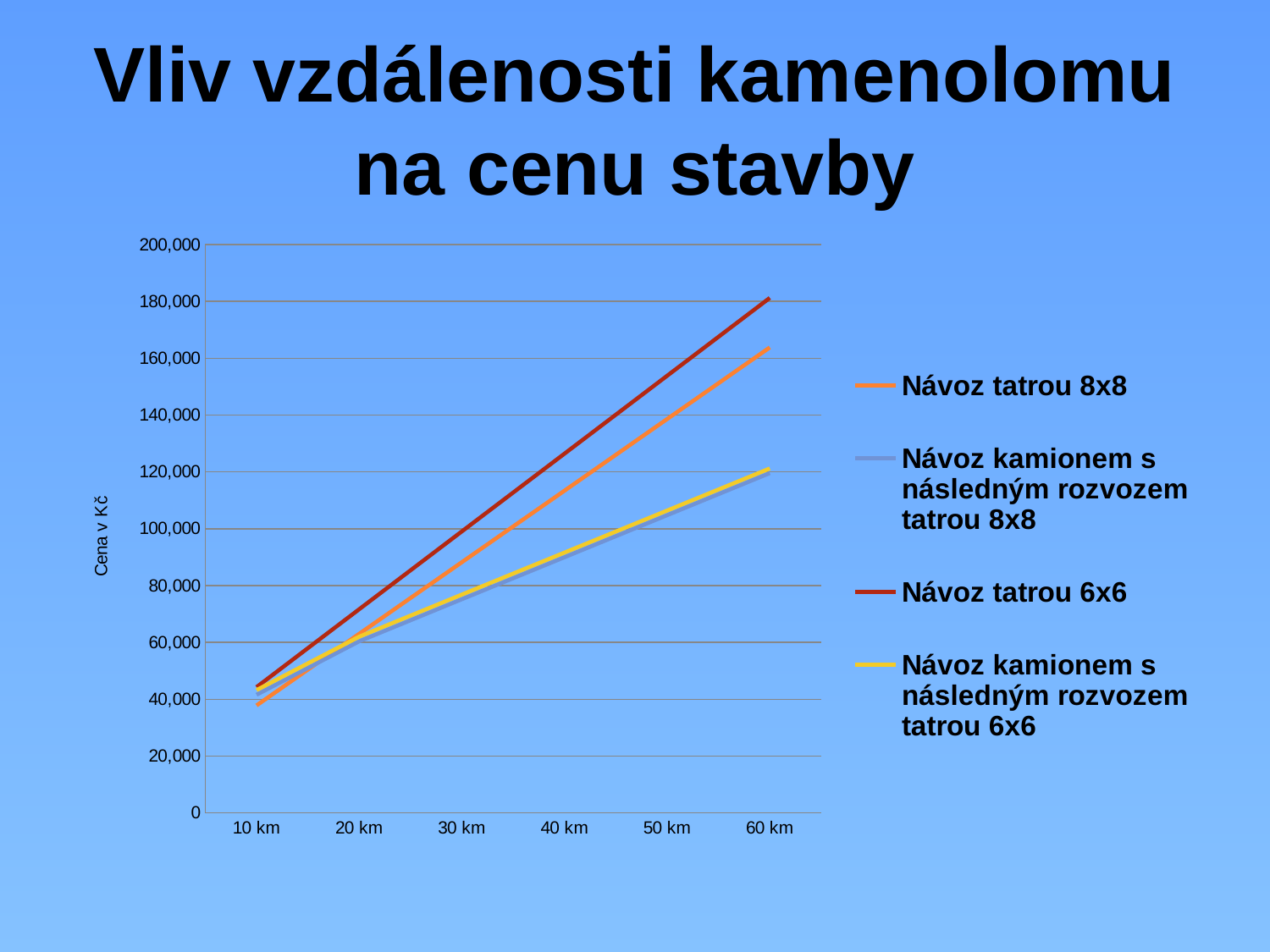
Is the value for Návoz tatrou 6x6 at 60 km greater or less than 160,000? greater Is the value for Návoz tatrou 8x8 at 10 km greater or less than 60,000? less What kind of chart is shown on the slide? line chart How many series does the legend list? 4 What is the label of the vertical axis? Cena v Kč How many distance categories are shown on the x axis? 6 Is the value for Návoz tatrou 6x6 at 50 km greater or less than 140,000? greater Do the values for Návoz tatrou 8x8 rise or fall as the distance increases from 10 km to 60 km? rise At 60 km, which is larger: the value for Návoz tatrou 6x6 or the value for Návoz tatrou 8x8? Návoz tatrou 6x6 Which series has the highest value at 60 km? Návoz tatrou 6x6